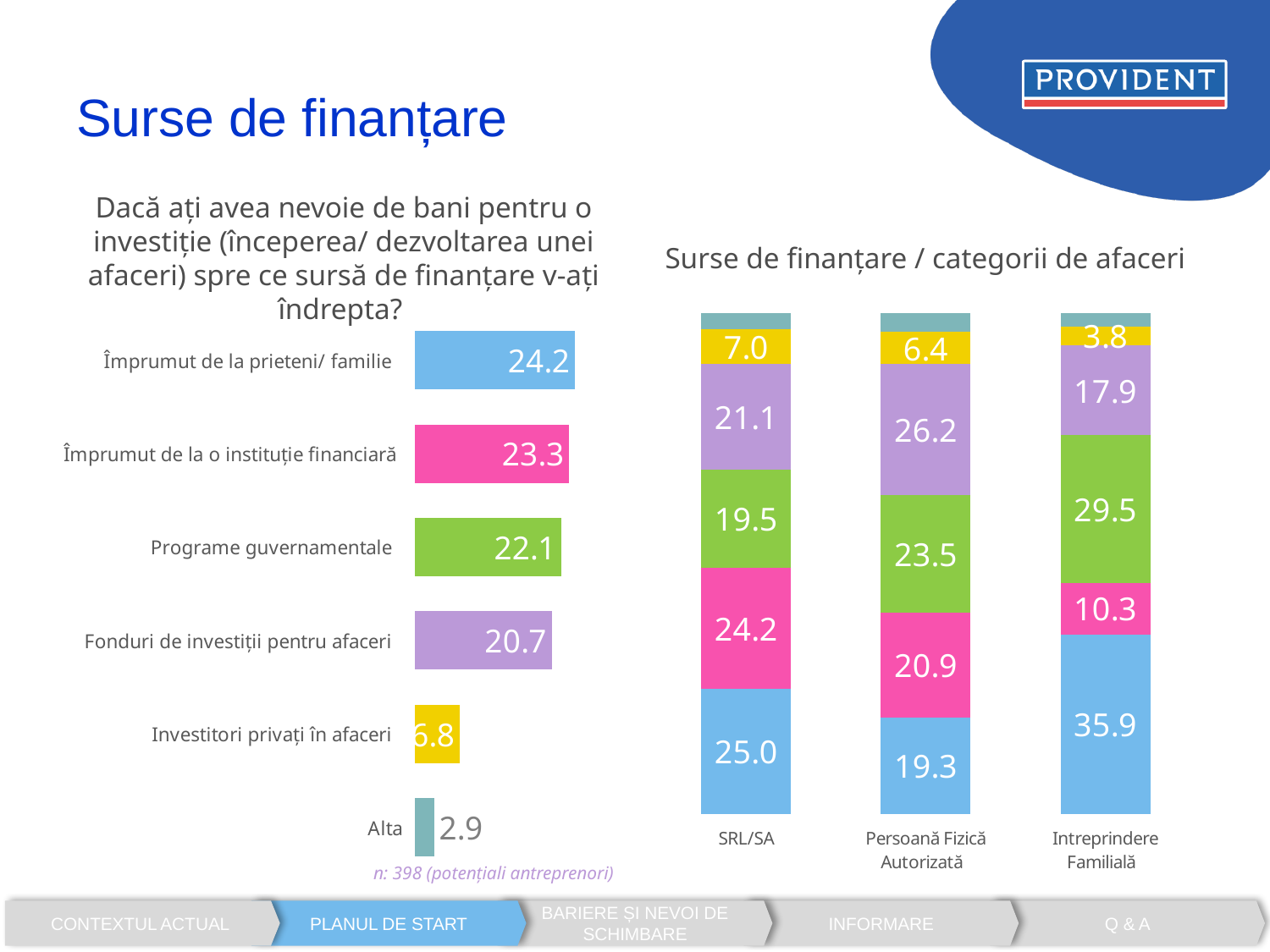
In the chart 'Surse de finanțare / categorii de afaceri', what is the value of the blue segment for 'Intreprindere Familială'? 35.9 In the chart 'Surse de finanțare / categorii de afaceri', what is the difference between the green segment for 'Intreprindere Familială' and the green segment for 'SRL/SA'? 10.0 In the chart 'Surse de finanțare / categorii de afaceri', which category has the largest blue segment? Intreprindere Familială What kind of chart is the left chart? bar chart In the left chart, how many categories are shown? 6 In the left chart, what is the difference between 'Împrumut de la prieteni/ familie' and 'Împrumut de la o instituție financiară'? 0.9 In the left chart, what is the value for 'Investitori privați în afaceri'? 6.8 In the left chart, which category has the lowest value? Alta In the left chart, what is the value for 'Împrumut de la prieteni/ familie'? 24.2 In the left chart, which category has the highest value? Împrumut de la prieteni/ familie In the chart 'Surse de finanțare / categorii de afaceri', how many business categories are shown on the x axis? 3 In the chart 'Surse de finanțare / categorii de afaceri', what is the value of the purple segment for 'Persoană Fizică Autorizată'? 26.2